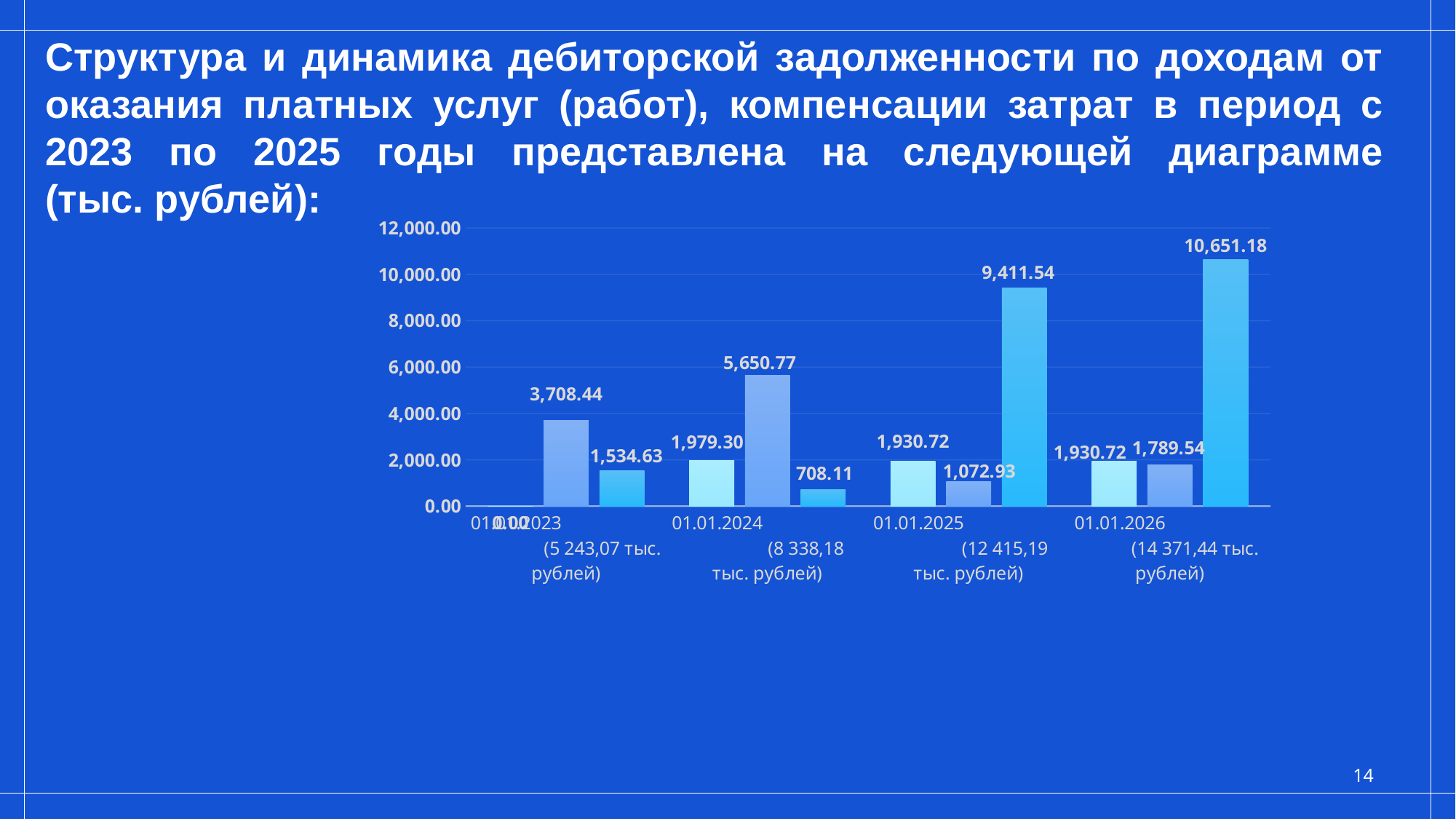
Which date group contains the highest bar on the chart? 01.01.2026 How many date categories are shown on the x axis of the chart? 4 What type of chart is shown on the slide? bar chart What is the value of the smallest bar in the 01.01.2024 group? 708.11 What is the value of the middle bar in the 01.01.2023 group? 3,708.44 Do the totals shown in parentheses under the category labels rise or fall from 01.01.2023 to 01.01.2026? rise What total (in parentheses) is shown under the 01.01.2025 category label? 12 415,19 тыс. рублей What is the value of the tallest bar in the 01.01.2025 group? 9,411.54 What is the value of the tallest bar in the 01.01.2026 group? 10,651.18 What is the value of the middle bar in the 01.01.2024 group? 5,650.77 Which is larger: the middle bar for 01.01.2024 or the middle bar for 01.01.2023? 01.01.2024 What is the difference between the tallest bar in the 01.01.2026 group (10,651.18) and the tallest bar in the 01.01.2025 group (9,411.54)? 1,239.64